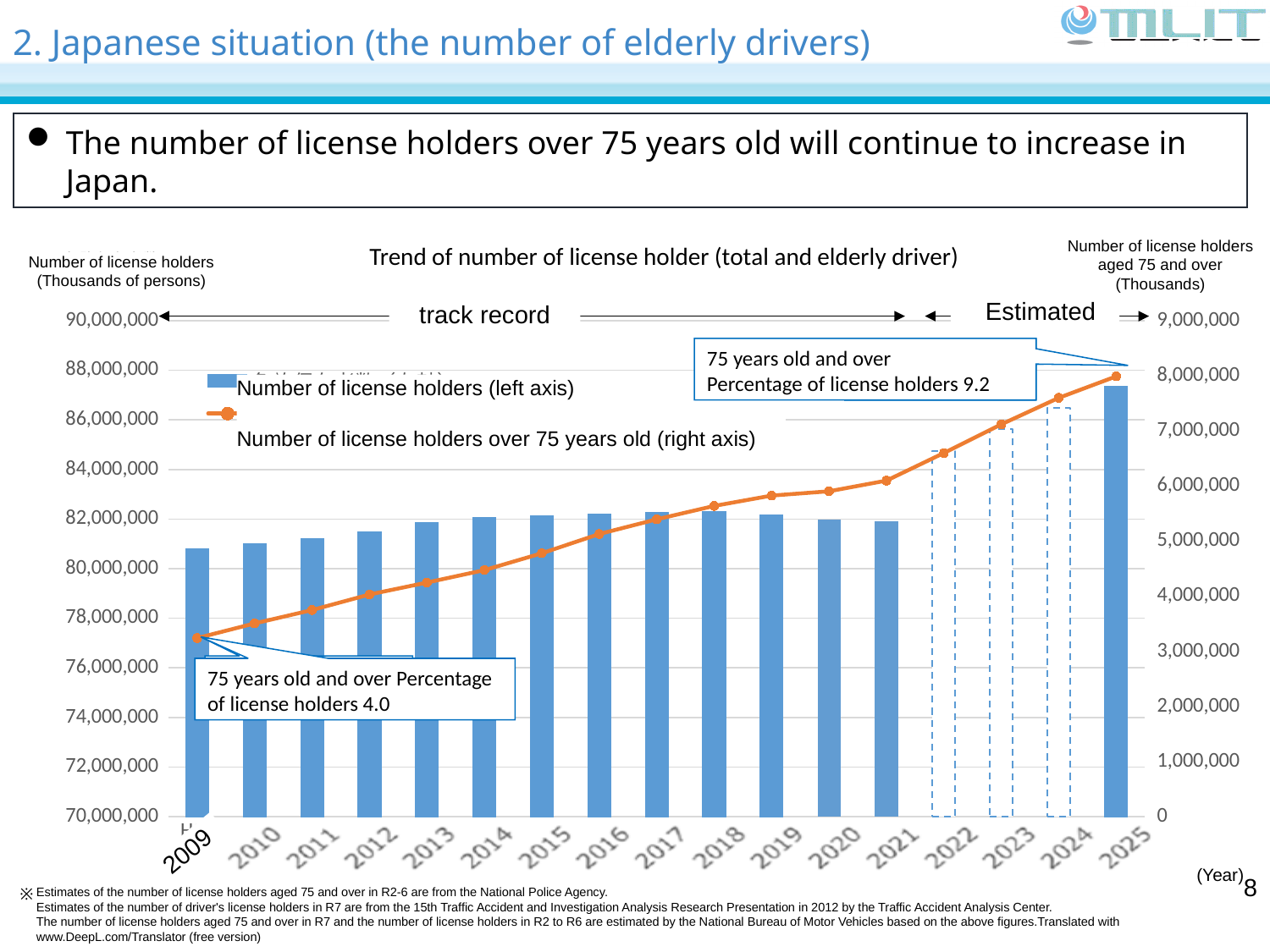
How many series does the chart's legend list? 2 Is the number of license holders over 75 years old in 2009 greater or less than 4,000,000? less Which year has the highest bar for the number of license holders? 2025 Does the number of license holders over 75 years old rise or fall from 2009 to 2025? Rise Is the number of license holders over 75 years old in 2025 greater or less than 7,000,000? greater Which year has the lowest bar for the number of license holders? 2009 Is the number of license holders (bar) in 2025 greater or less than 86,000,000? greater Which is larger, the number of license holders bar for 2016 or for 2009? 2016 What is the title of the chart? Trend of number of license holder (total and elderly driver) How many years are shown along the x axis of the chart? 17 What kind of chart is shown on the slide? A combined bar and line chart Which year has the lowest value on the line for license holders over 75 years old? 2009